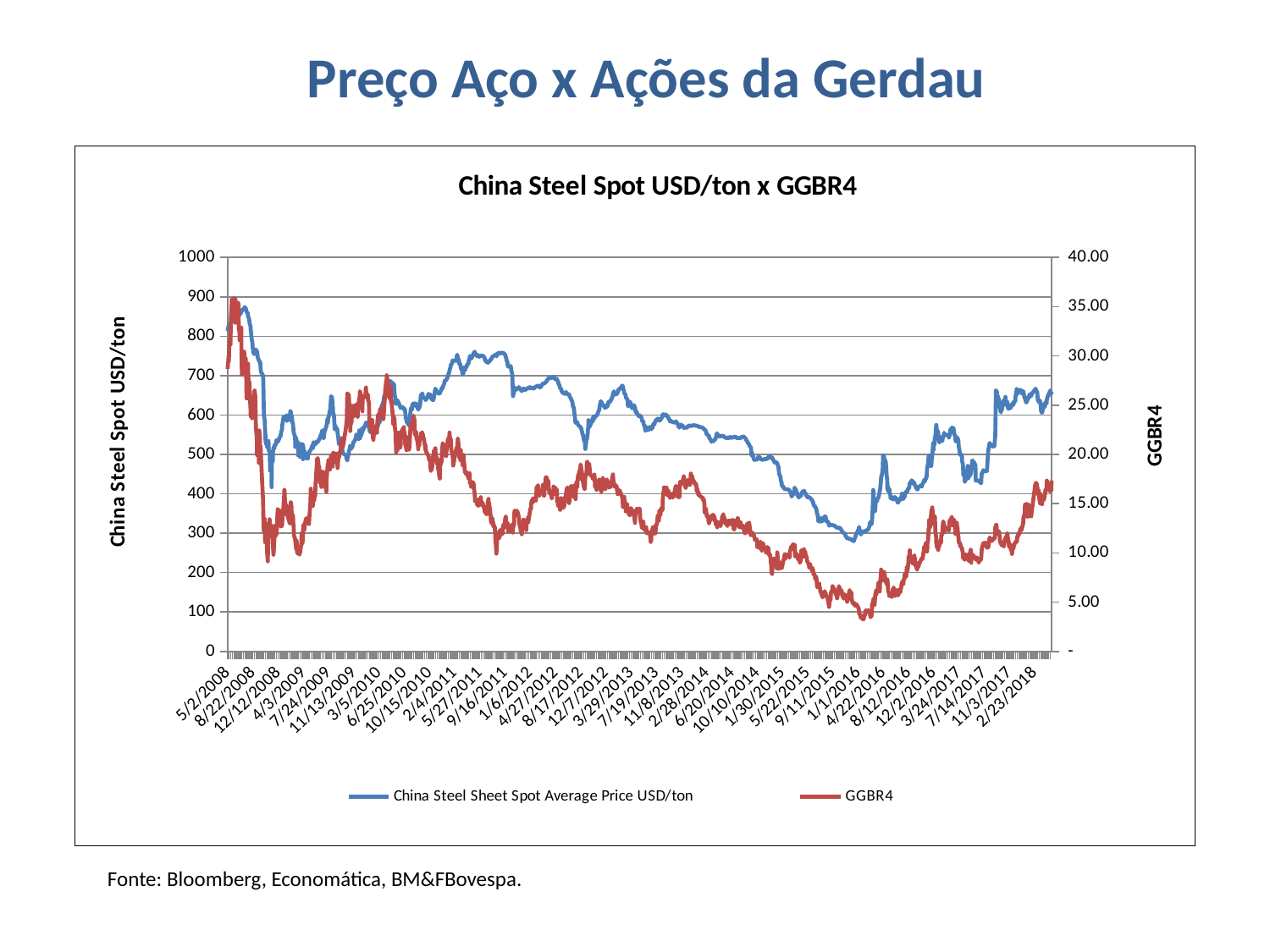
What kind of chart is shown on the slide? Line chart How many series does the legend list? 2 Does the China Steel Sheet Spot Average Price rise or fall between 5/2/2008 and 12/12/2008? fall Is the China Steel Sheet Spot Average Price at 2/23/2018 greater or less than 600? greater Which series is drawn in red? GGBR4 Is the China Steel Sheet Spot Average Price at 5/2/2008 greater or less than 800? greater Does the China Steel Sheet Spot Average Price rise or fall between 8/17/2012 and 9/11/2015? fall What is the title of the chart? China Steel Spot USD/ton x GGBR4 Does the GGBR4 series rise or fall between 1/1/2016 and 2/23/2018? rise Is the China Steel Sheet Spot Average Price around 1/1/2016 greater or less than 400? less